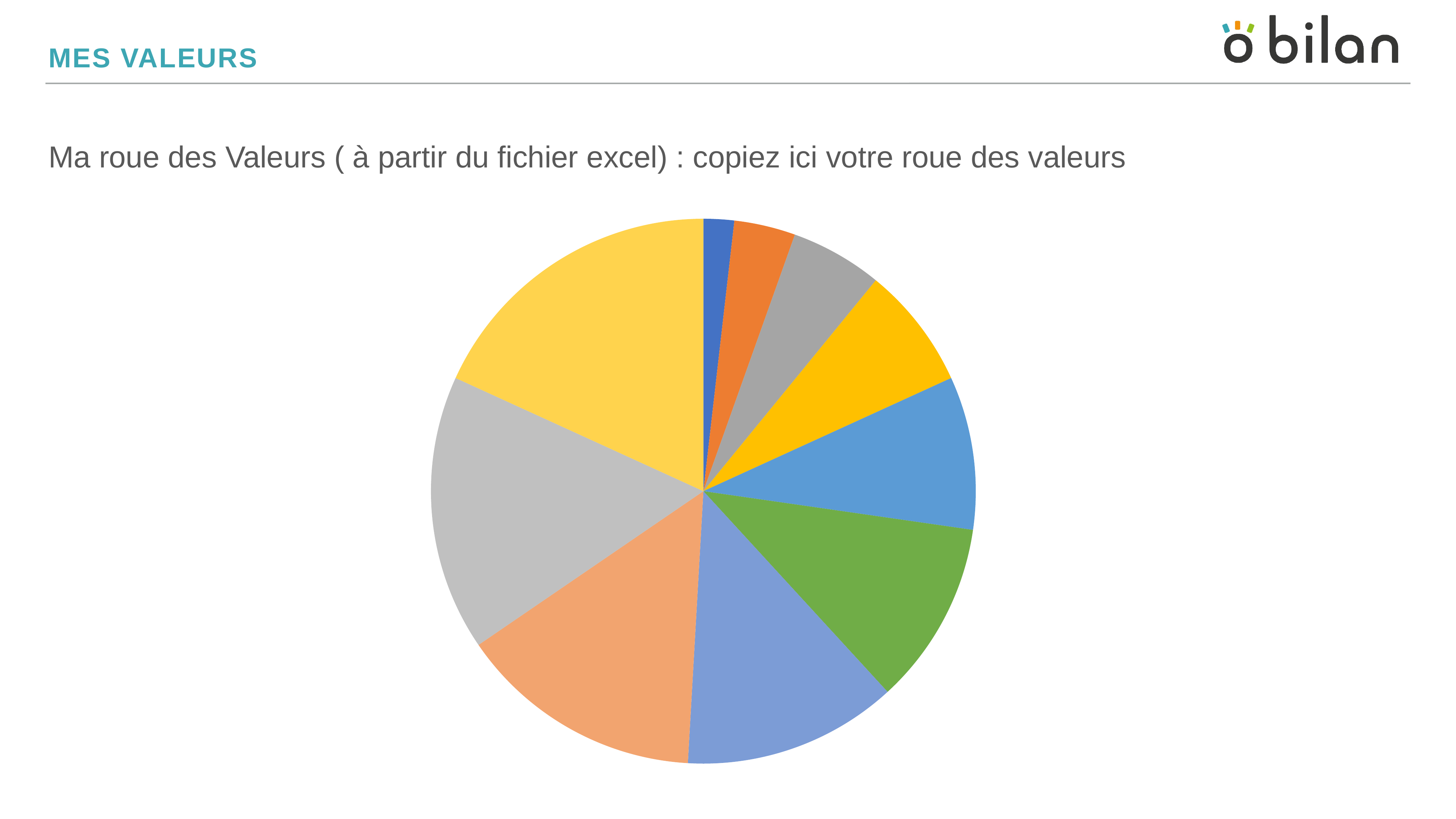
How many slices does the pie chart have? 10 Does the pie chart display a legend? No Which slice is larger, the periwinkle blue slice at the bottom or the gold slice at the top right? the periwinkle blue slice Which slice is larger, the salmon (light orange) slice at the bottom left or the orange slice at the top? the salmon slice What kind of chart is shown on the slide? pie chart What is the heading of the slide containing the pie chart? MES VALEURS Which slice is larger, the light yellow slice at the top left or the green slice on the right? the light yellow slice Which slice of the pie chart is the smallest? the dark blue slice at the top